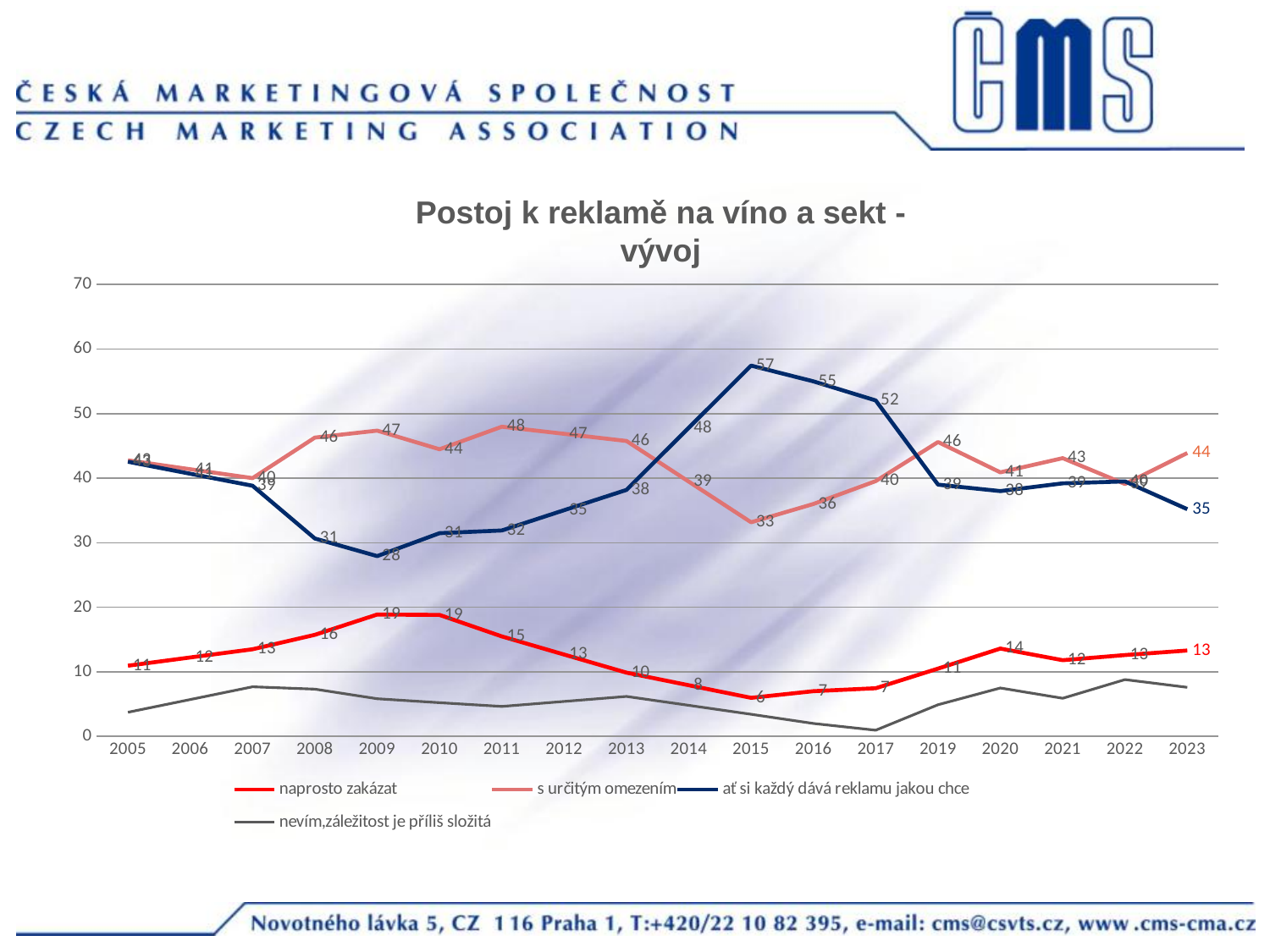
What is the value for 'ať si každý dává reklamu jakou chce' in 2015? 57 What kind of chart is shown on the slide? line chart What is the value for 'ať si každý dává reklamu jakou chce' in 2023? 35 How many series does the legend list? 4 Is the value for 'nevím,záležitost je příliš složitá' in 2017 greater or less than 10? less What is the value for 's určitým omezením' in 2023? 44 What is the difference between 's určitým omezením' and 'ať si každý dává reklamu jakou chce' in 2023? 9 In which year is 'ať si každý dává reklamu jakou chce' at its lowest? 2009 How many years are shown on the x axis? 18 What is the value for 'naprosto zakázat' in 2015? 6 In which year does 'ať si každý dává reklamu jakou chce' reach its highest value? 2015 In 2015, which is larger: 'ať si každý dává reklamu jakou chce' or 's určitým omezením'? ať si každý dává reklamu jakou chce